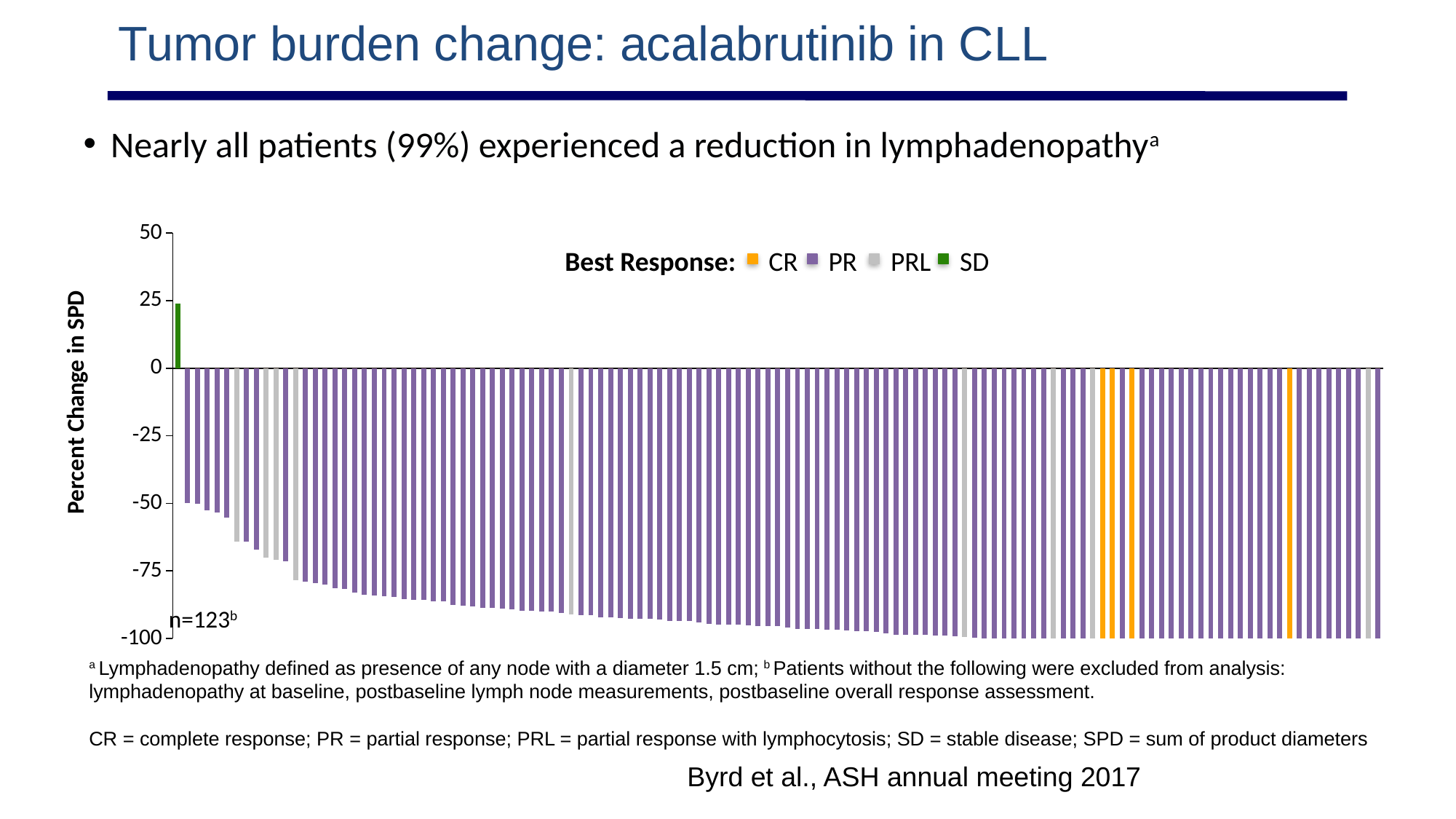
What is the label of the vertical axis? Percent Change in SPD Which best-response category has the only bar with a positive percent change in SPD? SD Is the value for the first purple PR bar (leftmost purple bar) greater or less than -25? less What is the lowest value shown on the vertical axis? -100 Which is larger, the value of the green SD bar or the value of the leftmost purple PR bar? the green SD bar Is the value for the green SD bar greater or less than 0? greater How many best-response categories does the legend list? 4 What are the best-response categories listed in the legend? CR, PR, PRL, SD How many patients are included in the chart, according to the n value shown? 123 What kind of chart is shown on the slide? bar chart Do the bar values rise or fall moving from left to right along the x axis? fall Is the value for the rightmost bar greater or less than -75? less